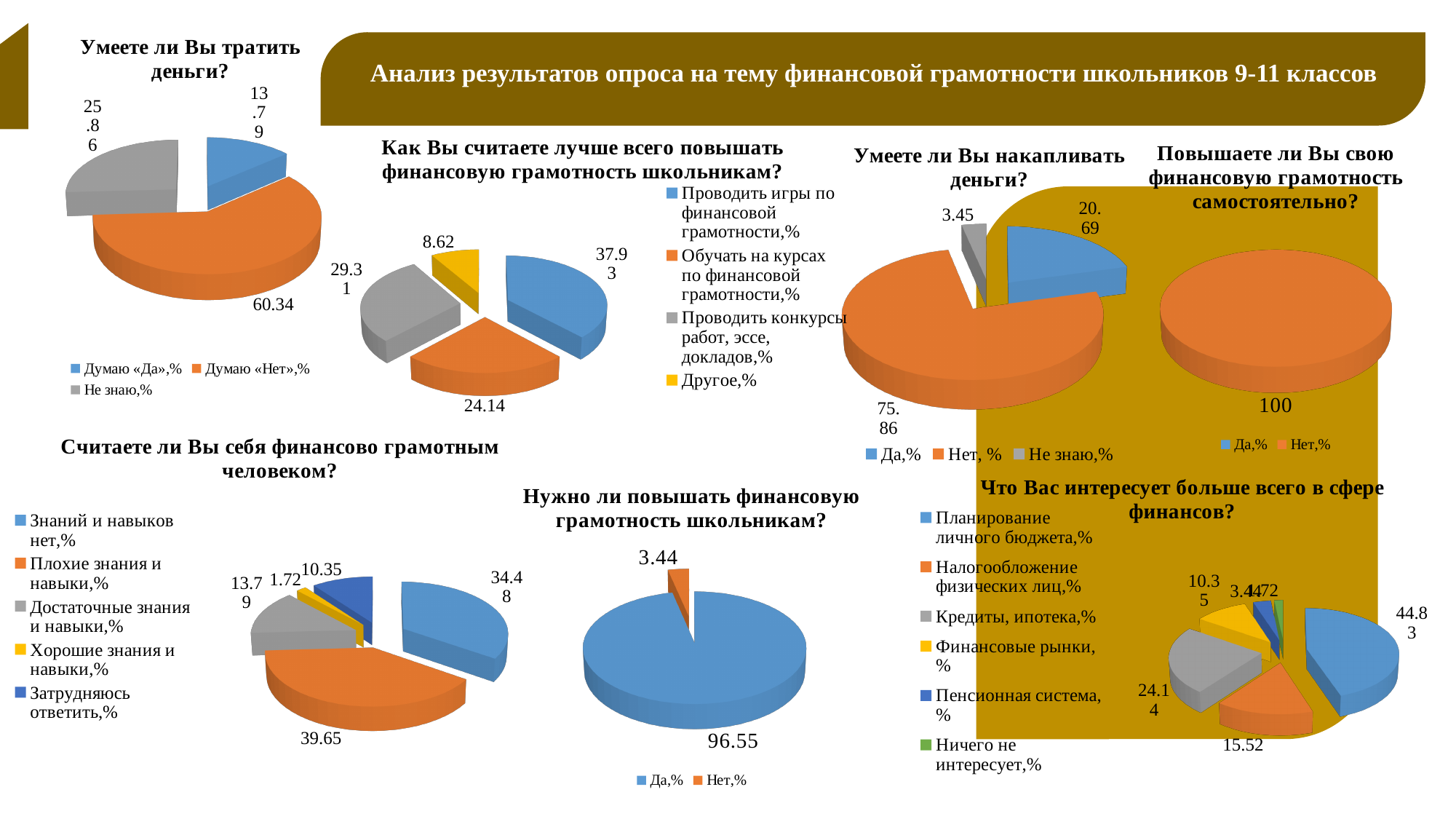
On the chart 'Как Вы считаете лучше всего повышать финансовую грамотность школьникам?', which category has the largest slice? Проводить игры по финансовой грамотности On the chart 'Умеете ли Вы тратить деньги?', what is the value for 'Думаю «Нет»'? 60.34 On the chart 'Умеете ли Вы накапливать деньги?', what is the difference between 'Нет' and 'Да'? 55.17 On the chart 'Как Вы считаете лучше всего повышать финансовую грамотность школьникам?', how many categories does the legend list? 4 On the chart 'Считаете ли Вы себя финансово грамотным человеком?', which is larger: 'Достаточные знания и навыки' or 'Затрудняюсь ответить'? Достаточные знания и навыки On the chart 'Считаете ли Вы себя финансово грамотным человеком?', what is the value for 'Плохие знания и навыки'? 39.65 On the chart 'Нужно ли повышать финансовую грамотность школьникам?', what is the value for 'Да'? 96.55 On the chart 'Как Вы считаете лучше всего повышать финансовую грамотность школьникам?', what is the value for 'Другое'? 8.62 On the chart 'Умеете ли Вы тратить деньги?', which category has the smallest slice? Думаю «Да» On the chart 'Что Вас интересует больше всего в сфере финансов?', what is the value for 'Кредиты, ипотека'? 24.14 On the chart 'Повышаете ли Вы свою финансовую грамотность самостоятельно?', what value is shown for 'Нет'? 100 On the chart 'Умеете ли Вы накапливать деньги?', what is the value for 'Нет'? 75.86